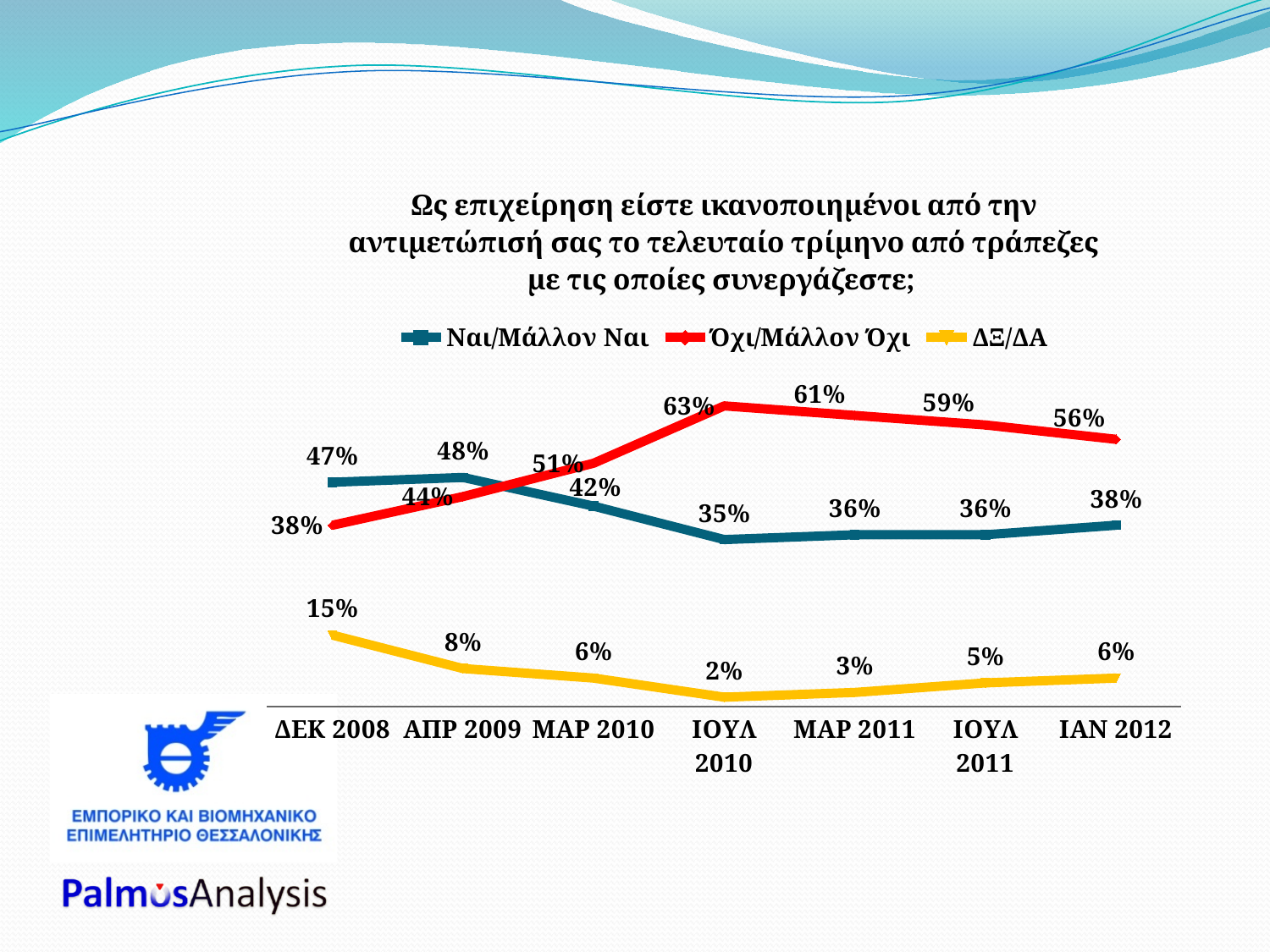
Which series is larger in ΔΕΚ 2008, Ναι/Μάλλον Ναι or Όχι/Μάλλον Όχι? Ναι/Μάλλον Ναι Does the Όχι/Μάλλον Όχι series rise or fall from ΔΕΚ 2008 to ΙΟΥΛ 2010? Rise At which time point is ΔΞ/ΔΑ lowest? ΙΟΥΛ 2010 What kind of chart is shown on the slide? Line chart What is the value of ΔΞ/ΔΑ in ΙΑΝ 2012? 6% How many time points are shown on the x axis? 7 What is the value of Ναι/Μάλλον Ναι in ΔΕΚ 2008? 47% What is the value of Όχι/Μάλλον Όχι in ΙΟΥΛ 2010? 63% Which series is drawn in red? Όχι/Μάλλον Όχι At which time point does Όχι/Μάλλον Όχι reach its highest value? ΙΟΥΛ 2010 How many series does the legend list? 3 What is the difference between Όχι/Μάλλον Όχι and Ναι/Μάλλον Ναι in ΙΑΝ 2012? 18%